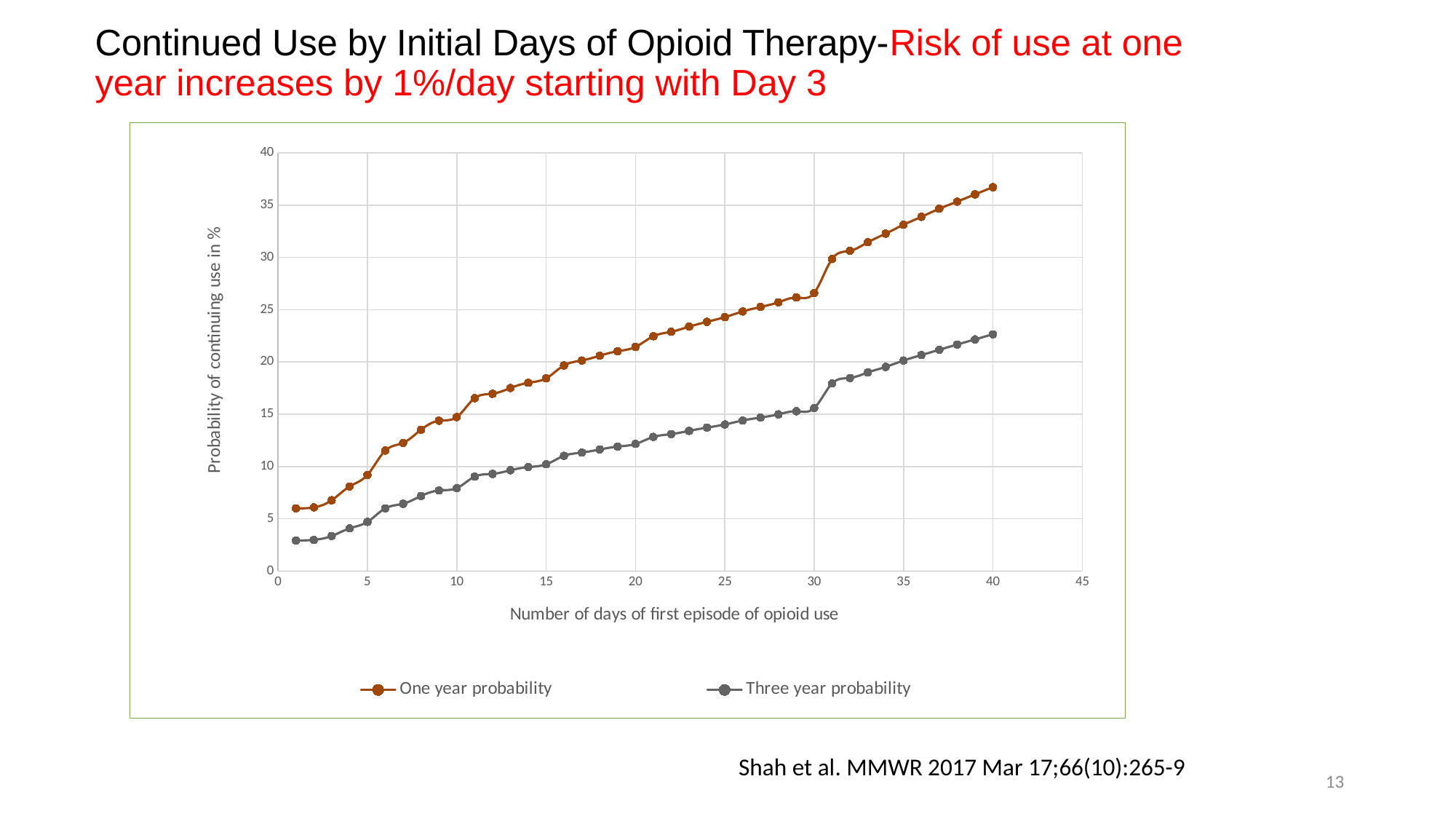
Is the Three year probability value at 10 days greater or less than 10? less Which series is plotted in orange? One year probability What kind of chart is shown on the slide? line chart At 20 days, which series has the higher value, One year probability or Three year probability? One year probability How many series does the legend list? 2 Is the Three year probability value at 1 day greater or less than 5? less Which series reaches the highest value on the chart? One year probability Do the values of the One year probability series rise or fall as the number of days increases? rise Do the values of the Three year probability series rise or fall as the number of days increases? rise Is the Three year probability value at 40 days greater or less than 20? greater What is the label of the y axis? Probability of continuing use in %